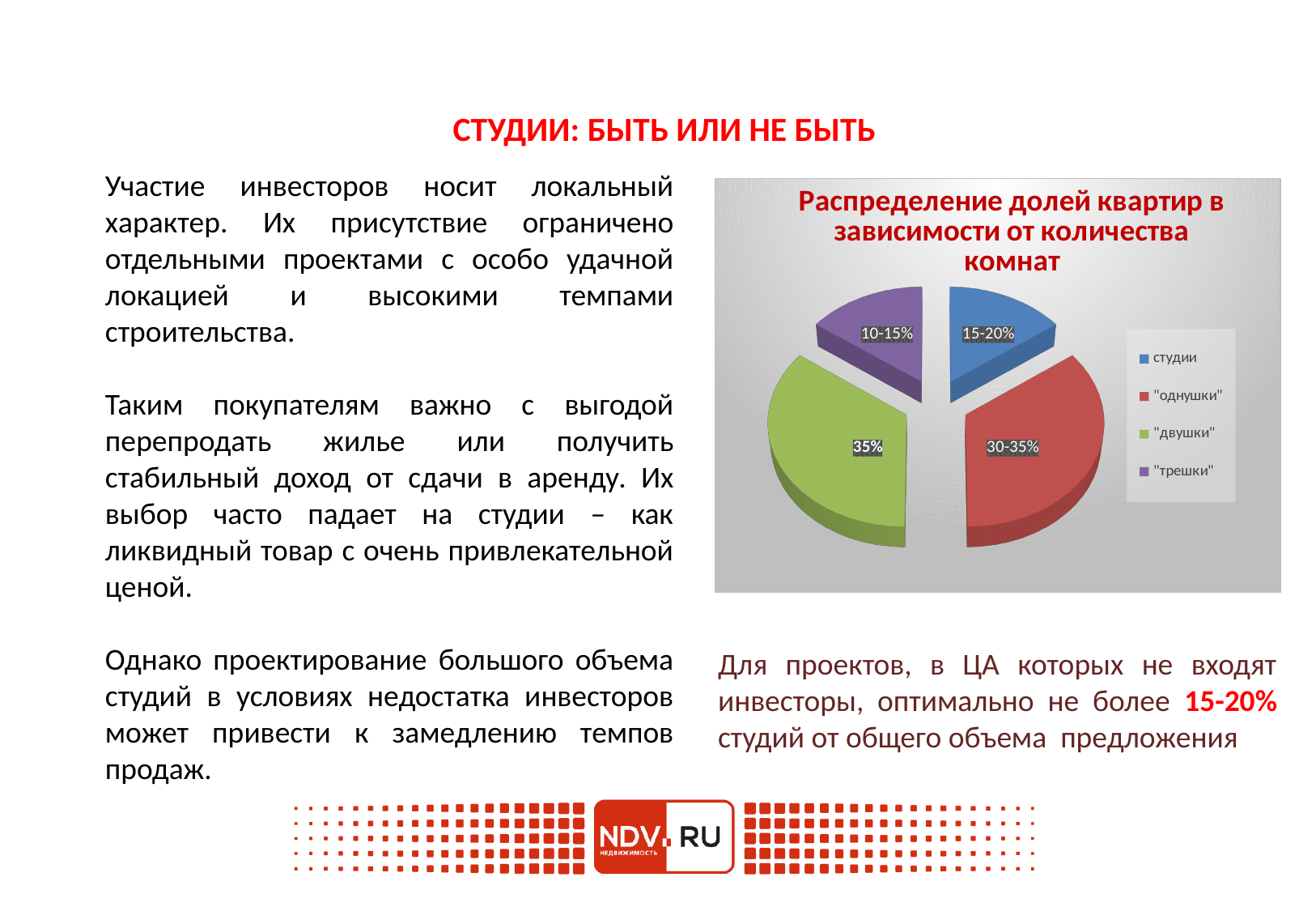
What share of the pie is labelled for "двушки"? 35% What share of the pie is labelled for "трешки"? 10-15% What is the title of the chart? Распределение долей квартир в зависимости от количества комнат What type of chart is shown on the slide? pie chart What share of the pie is labelled for "студии"? 15-20% How many categories does the pie chart have? 4 What colour is the slice for "двушки" in the pie chart? green Which slice is larger: "двушки" or "трешки"? "двушки" What share of the pie is labelled for "однушки"? 30-35% How many entries does the chart legend list? 4